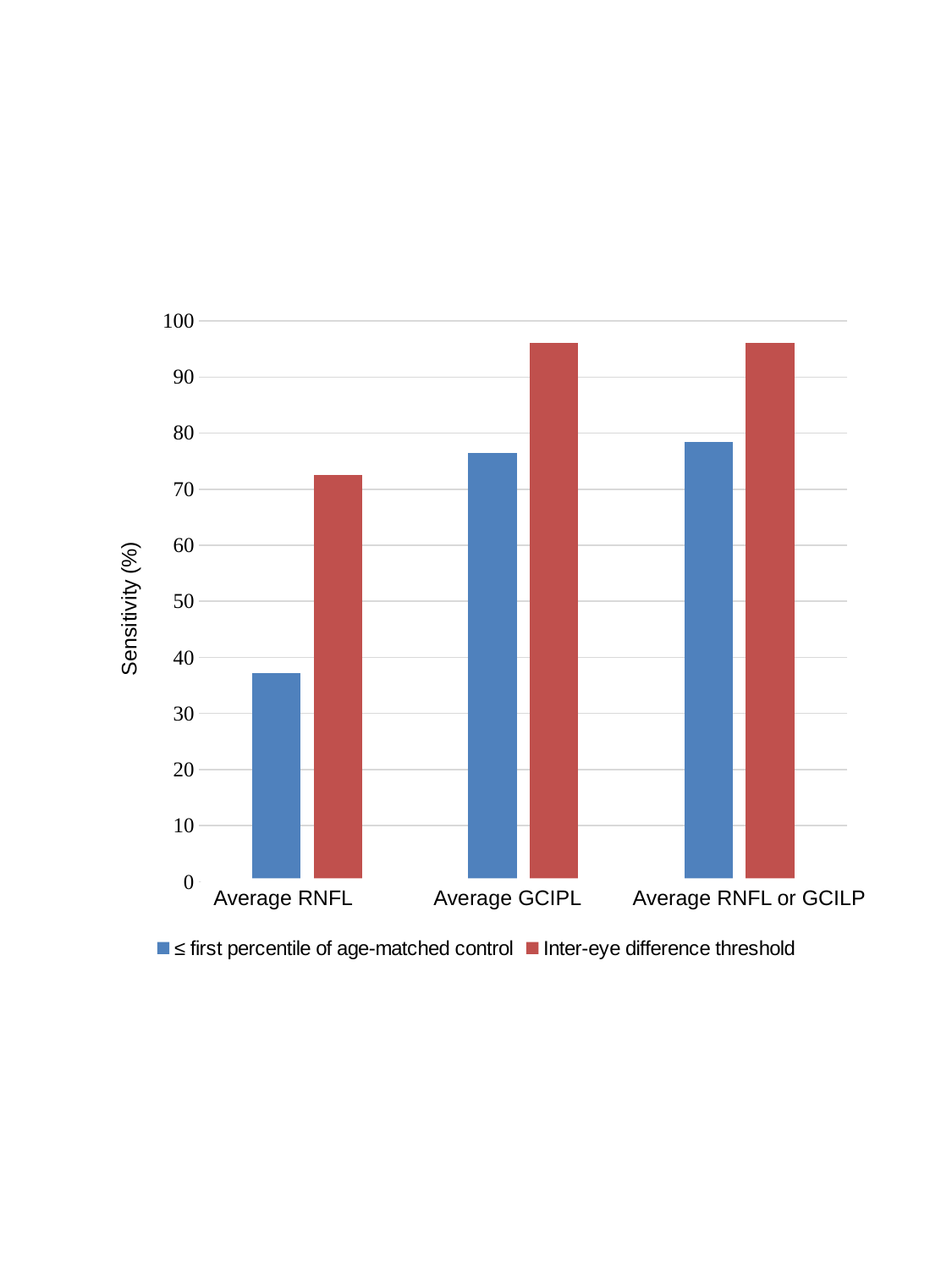
Is the value for Average RNFL in the 'Inter-eye difference threshold' series greater or less than 70? greater How many categories are shown on the x axis? 3 For Average RNFL, which series has the larger value: '≤ first percentile of age-matched control' or 'Inter-eye difference threshold'? Inter-eye difference threshold What is the label of the y axis? Sensitivity (%) Which category has the lowest value in the '≤ first percentile of age-matched control' series? Average RNFL Is the value for Average RNFL in the '≤ first percentile of age-matched control' series greater or less than 40? less How many series does the legend list? 2 Which category has the lowest value in the 'Inter-eye difference threshold' series? Average RNFL Is the value for Average RNFL or GCILP in the '≤ first percentile of age-matched control' series greater or less than 80? less What kind of chart is shown on the slide? bar chart Which series is shown in red? Inter-eye difference threshold